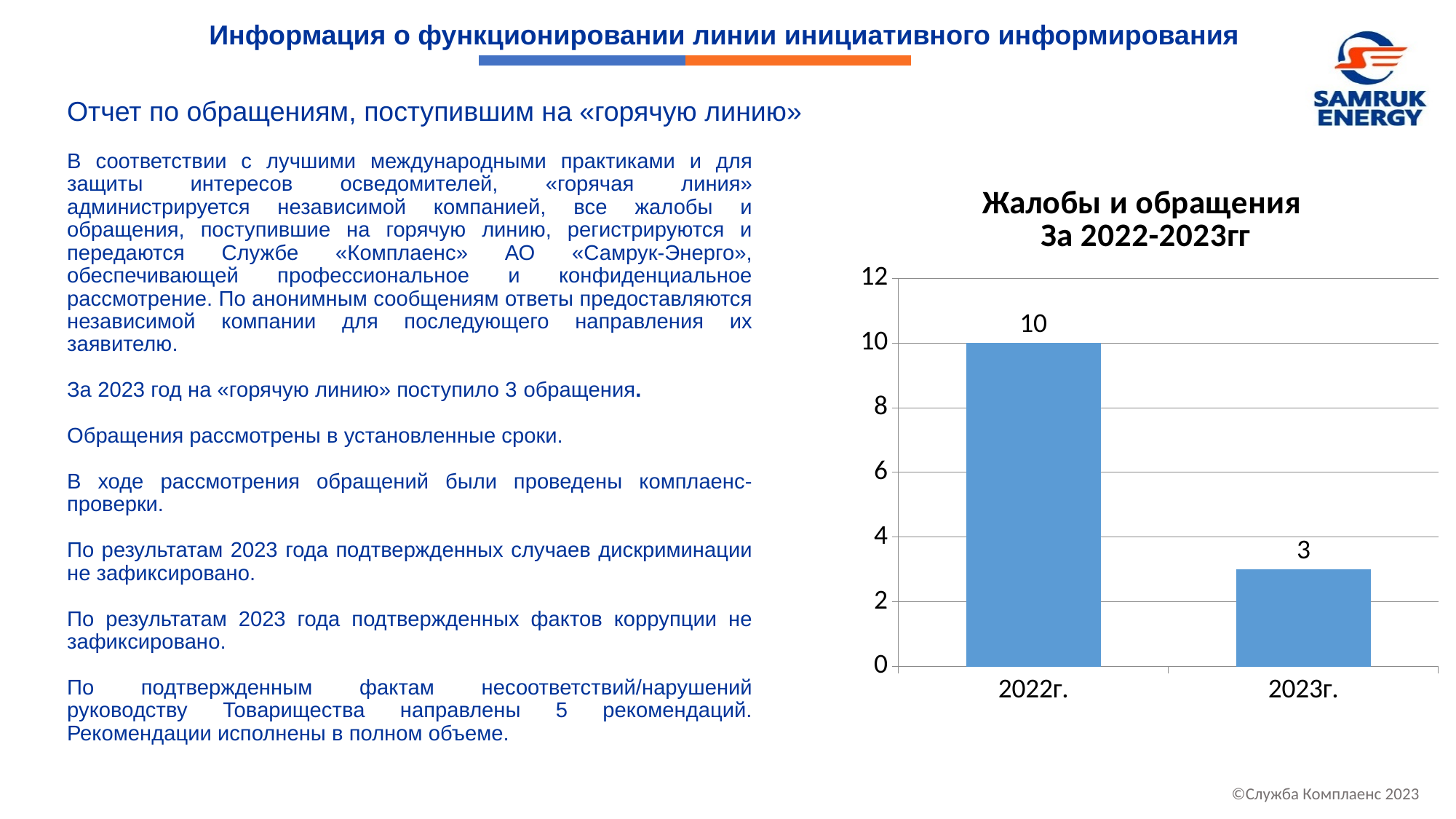
Is the value for 2022г. greater or less than 8? greater Do the values rise or fall from 2022г. to 2023г.? fall What is the value for 2023г. in the chart? 3 Which year has the highest value in the chart? 2022г. Which is larger, the value for 2022г. or the value for 2023г.? 2022г. What is the title of the chart? Жалобы и обращения За 2022-2023гг What kind of chart is shown on the slide? bar chart Which year has the lowest value in the chart? 2023г. What is the value for 2022г. in the chart? 10 What is the difference between the values for 2022г. and 2023г.? 7 How many categories are shown on the x axis of the chart? 2 Is the value for 2023г. greater or less than 4? less